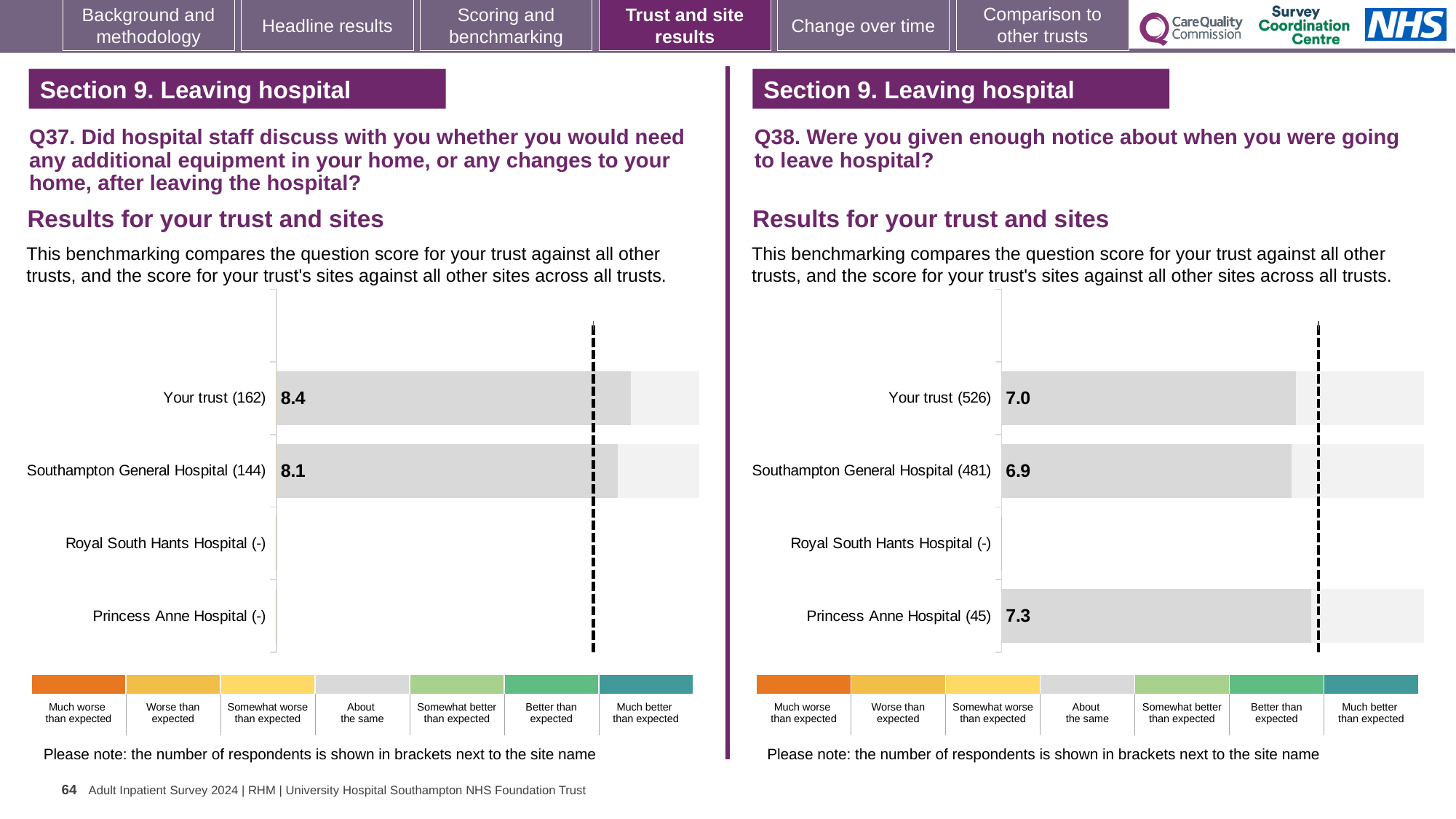
In the Q37 chart on the left, what is the score for Southampton General Hospital? 8.1 In the Q38 chart on the right, what is the difference between the score for Princess Anne Hospital and the score for Your trust? 0.3 In the Q38 chart on the right, what is the score for Your trust? 7.0 In the Q38 chart on the right, what is the score for Princess Anne Hospital? 7.3 In the Q37 chart on the left, which has the higher score: Your trust or Southampton General Hospital? Your trust In the Q37 chart on the left, what is the difference between the score for Your trust and the score for Southampton General Hospital? 0.3 In the Q38 chart on the right, what is the score for Southampton General Hospital? 6.9 What kind of chart is used on the left for Q37? Bar chart In the Q38 chart on the right, how many respondents are shown in brackets for Your trust? 526 In the Q38 chart on the right, which site or trust has the highest score? Princess Anne Hospital In the Q38 chart on the right, which site or trust has the lowest score shown? Southampton General Hospital In the Q37 chart on the left, what is the score for Your trust? 8.4